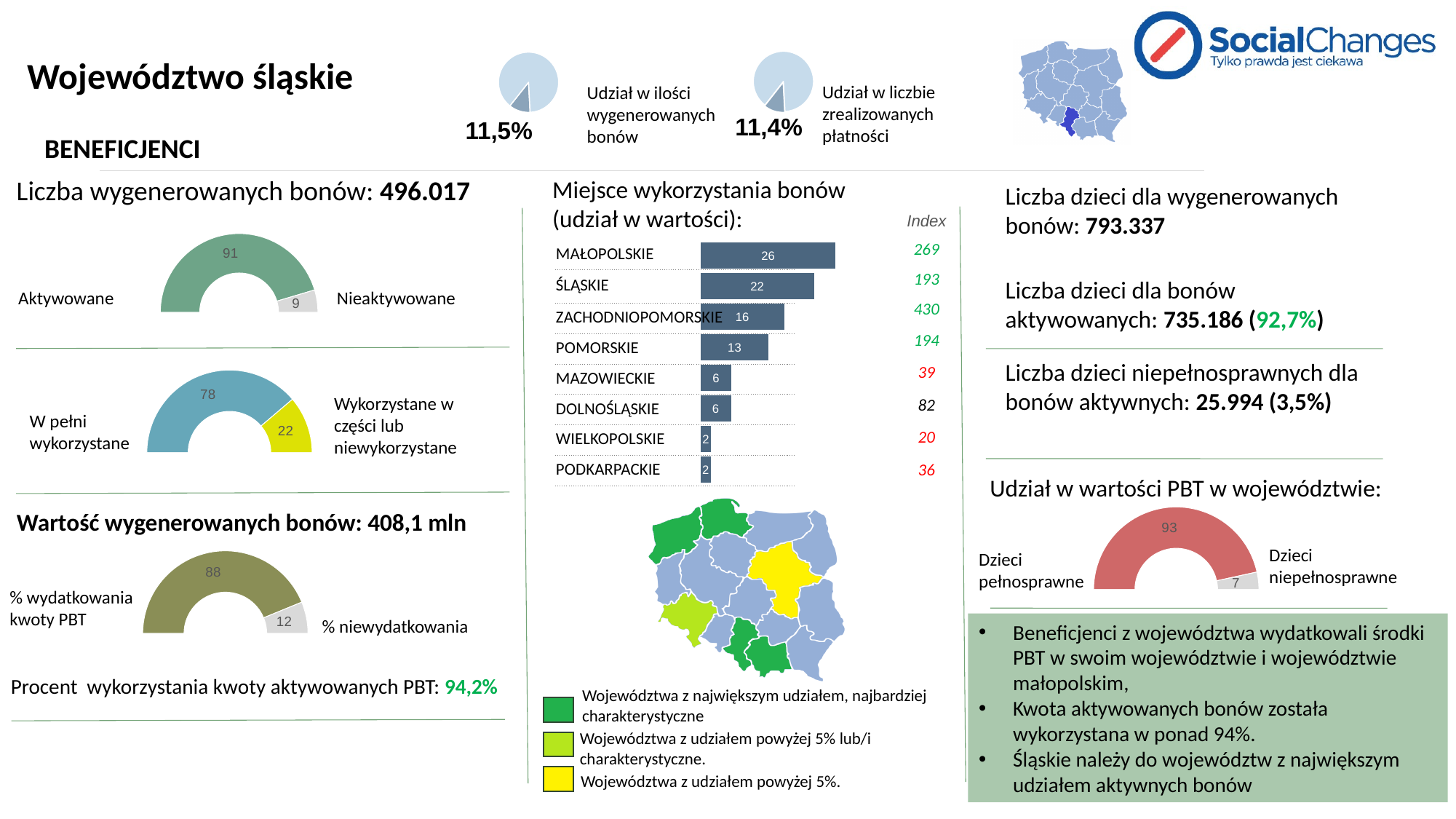
In the bar chart 'Miejsce wykorzystania bonów (udział w wartości)', what is the difference between the values for MAŁOPOLSKIE and ŚLĄSKIE? 4 In the chart with 'W pełni wykorzystane', what is the value for 'Wykorzystane w części lub niewykorzystane'? 22 In the bar chart 'Miejsce wykorzystania bonów (udział w wartości)', what is the Index value shown for ZACHODNIOPOMORSKIE? 430 In the chart 'Udział w wartości PBT w województwie', what is the value for 'Dzieci pełnosprawne'? 93 What type of chart is 'Miejsce wykorzystania bonów (udział w wartości)'? bar chart In the chart under 'Liczba wygenerowanych bonów', what is the value for Nieaktywowane? 9 In the bar chart 'Miejsce wykorzystania bonów (udział w wartości)', which is larger: the value for POMORSKIE or the value for MAZOWIECKIE? POMORSKIE In the bar chart 'Miejsce wykorzystania bonów (udział w wartości)', what is the value for ŚLĄSKIE? 22 In the chart under 'Liczba wygenerowanych bonów', what is the value for Aktywowane? 91 In the bar chart 'Miejsce wykorzystania bonów (udział w wartości)', how many voivodeships are listed? 8 In the chart under 'Wartość wygenerowanych bonów', what is the value for '% niewydatkowania'? 12 In the bar chart 'Miejsce wykorzystania bonów (udział w wartości)', which voivodeship has the highest value? MAŁOPOLSKIE